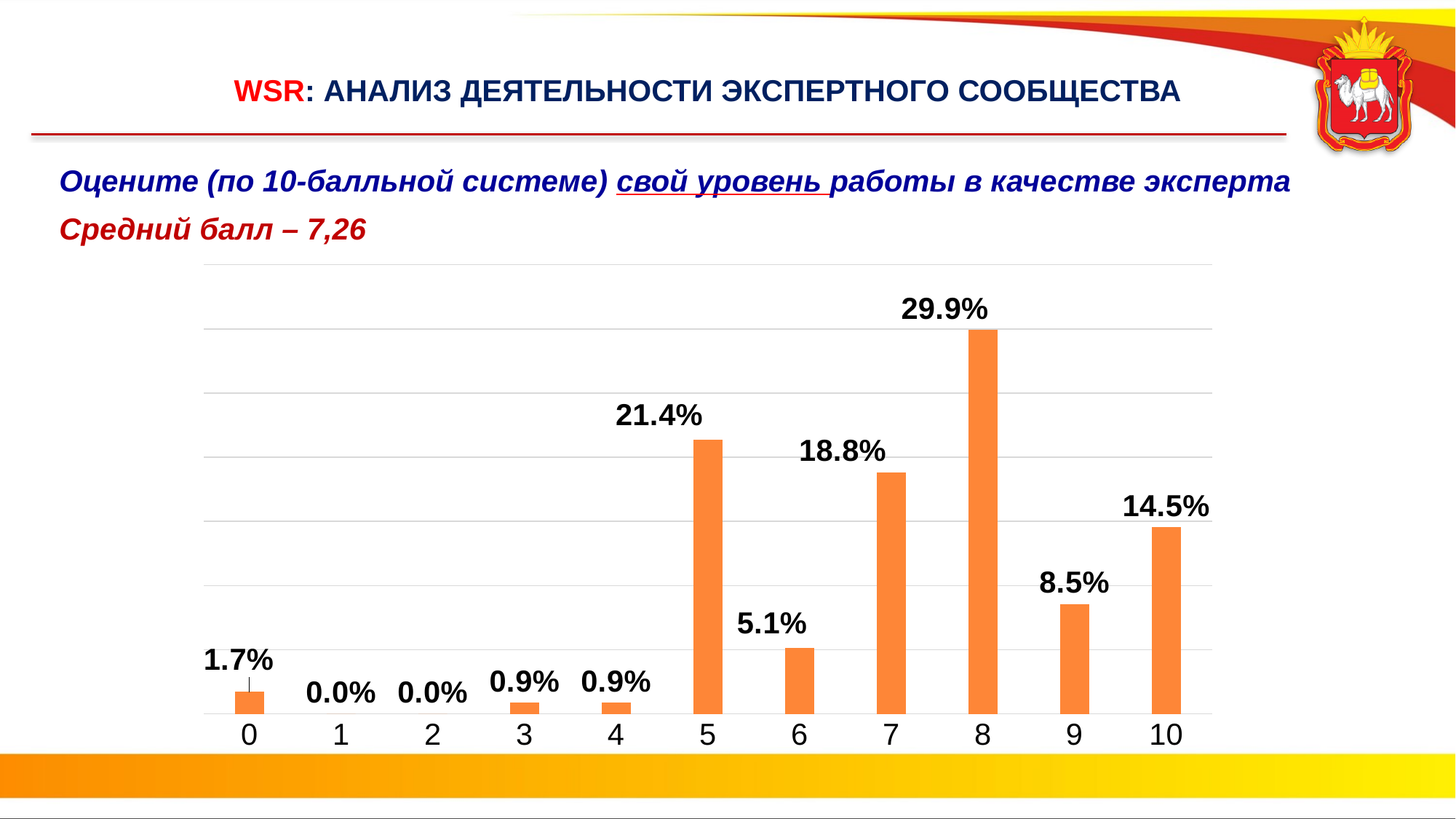
What is the value shown for rating 0? 1.7% Which has a larger percentage, rating 9 or rating 10? 10 What type of chart is shown on the slide? bar chart What is the difference between the percentages for rating 5 and rating 6? 16.3% What percentage of respondents gave a rating of 5? 21.4% What average score (Средний балл) is stated on the slide? 7,26 How many rating categories are shown on the x axis? 11 Which rating has the highest percentage of respondents? 8 Which ratings have a value of 0.0%? 1 and 2 What percentage of respondents rated their level of work as an expert at 8? 29.9% What is the value shown for rating 10? 14.5% What is the difference between the percentages for rating 8 and rating 7? 11.1%